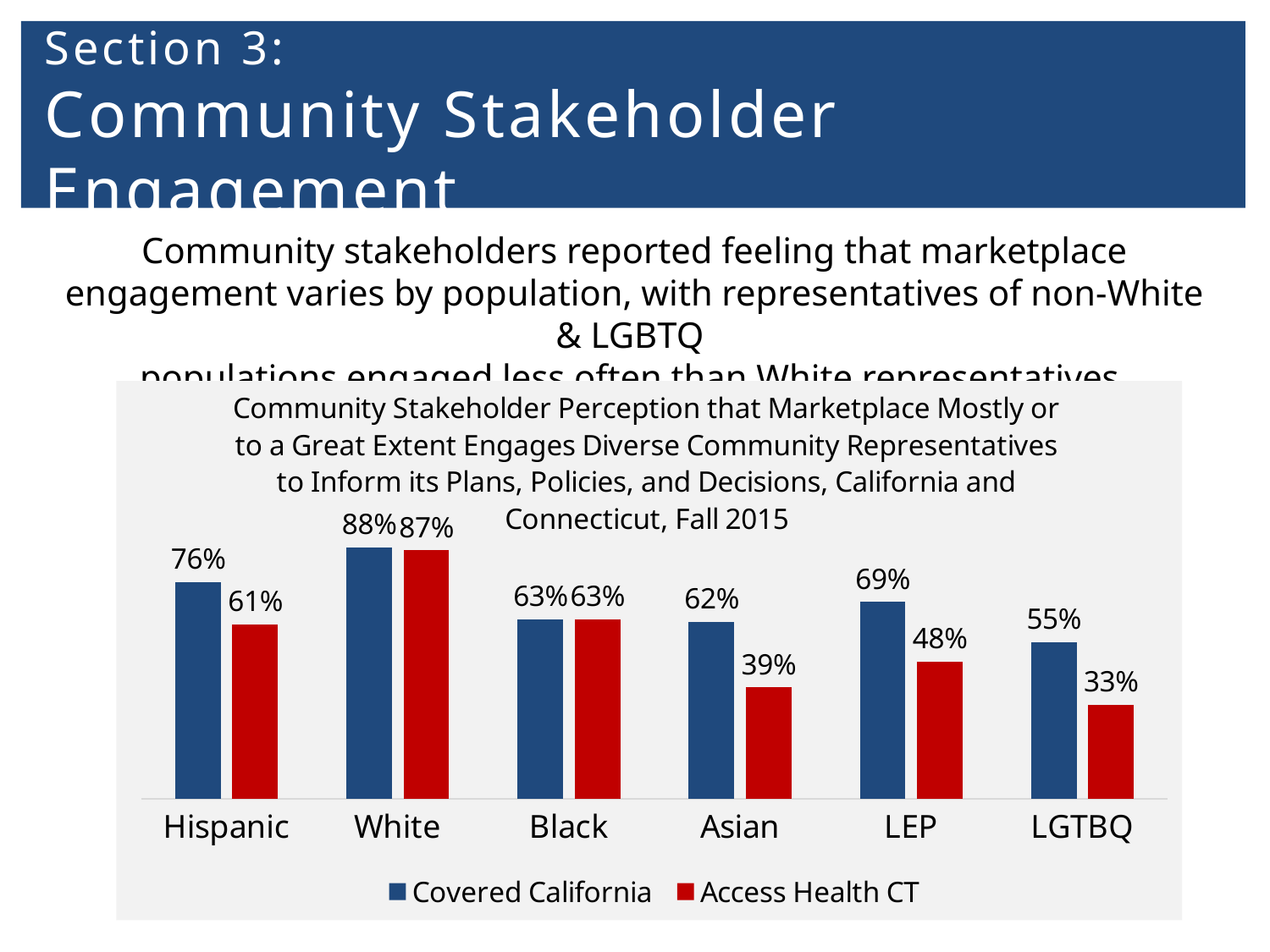
How many categories are shown on the x axis? 6 What is the Covered California value for Hispanic? 76% Which series is shown in red in the legend? Access Health CT How many series does the legend list? 2 What is the Access Health CT value for LGTBQ? 33% What kind of chart is shown on the slide? Bar chart What is the difference between the Covered California value for White and the Covered California value for Black? 25% Which category has the highest Covered California value? White Which category has the lowest Access Health CT value? LGTBQ Which is larger for Hispanic: the Covered California value or the Access Health CT value? Covered California What is the difference between the Covered California and Access Health CT values for LEP? 21% What is the Access Health CT value for Asian? 39%